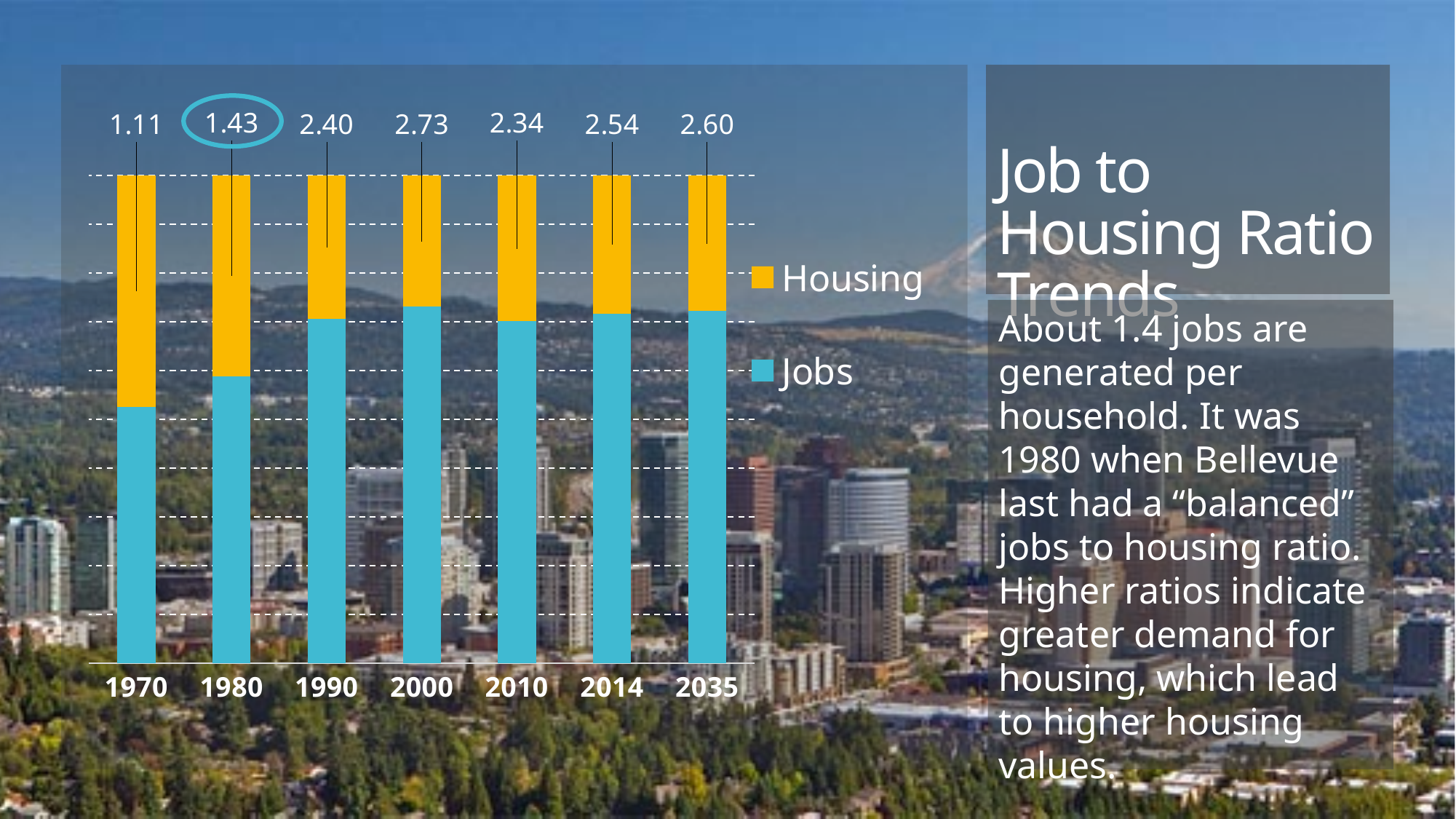
Which year has a larger ratio label, 2010 or 2014? 2014 What is the job to housing ratio shown for 2035? 2.60 How many years are shown on the x axis of the chart? 7 What is the job to housing ratio shown for 2000? 2.73 What is the job to housing ratio shown for 1970? 1.11 What is the difference between the ratio labels for 1980 and 1970? 0.32 Which year's ratio label is circled on the chart? 1980 How many series does the chart legend list? 2 What kind of chart is shown on the slide? Stacked bar chart What is the difference between the ratio labels for 2000 and 1970? 1.62 Which year has the lowest job to housing ratio label? 1970 Which year has the highest job to housing ratio label? 2000